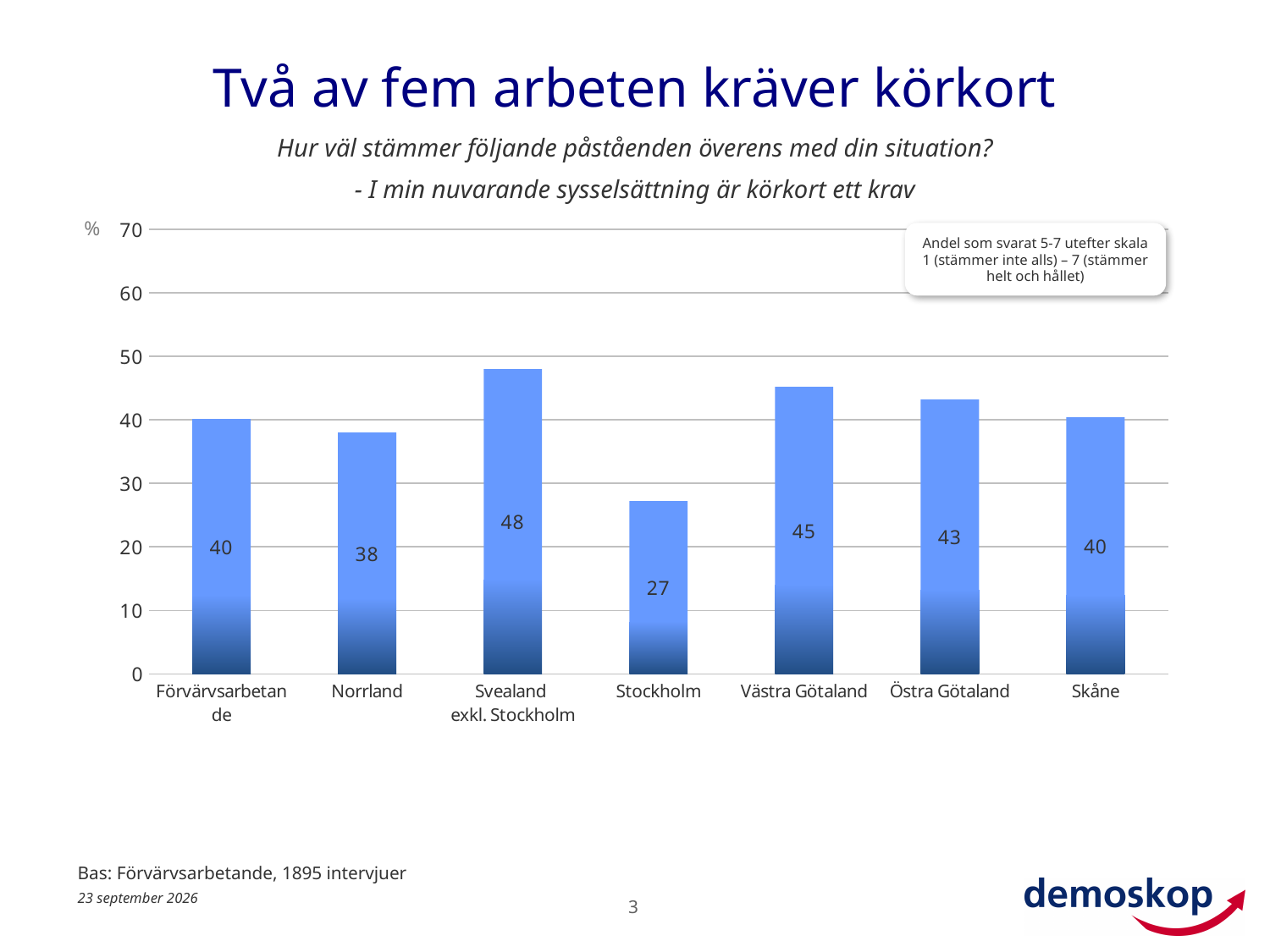
How many categories are shown on the x axis? 7 What is the value for Norrland? 38 What is the title of the slide? Två av fem arbeten kräver körkort Which is larger, the value for Östra Götaland or the value for Norrland? Östra Götaland Which category has the highest value? Svealand exkl. Stockholm Is the value for Stockholm greater or less than 30? less What kind of chart is shown on the slide? bar chart What is the value for Svealand exkl. Stockholm? 48 What is the value for Västra Götaland? 45 Which category has the lowest value? Stockholm What is the value for Stockholm? 27 What is the difference between the values for Svealand exkl. Stockholm and Stockholm? 21